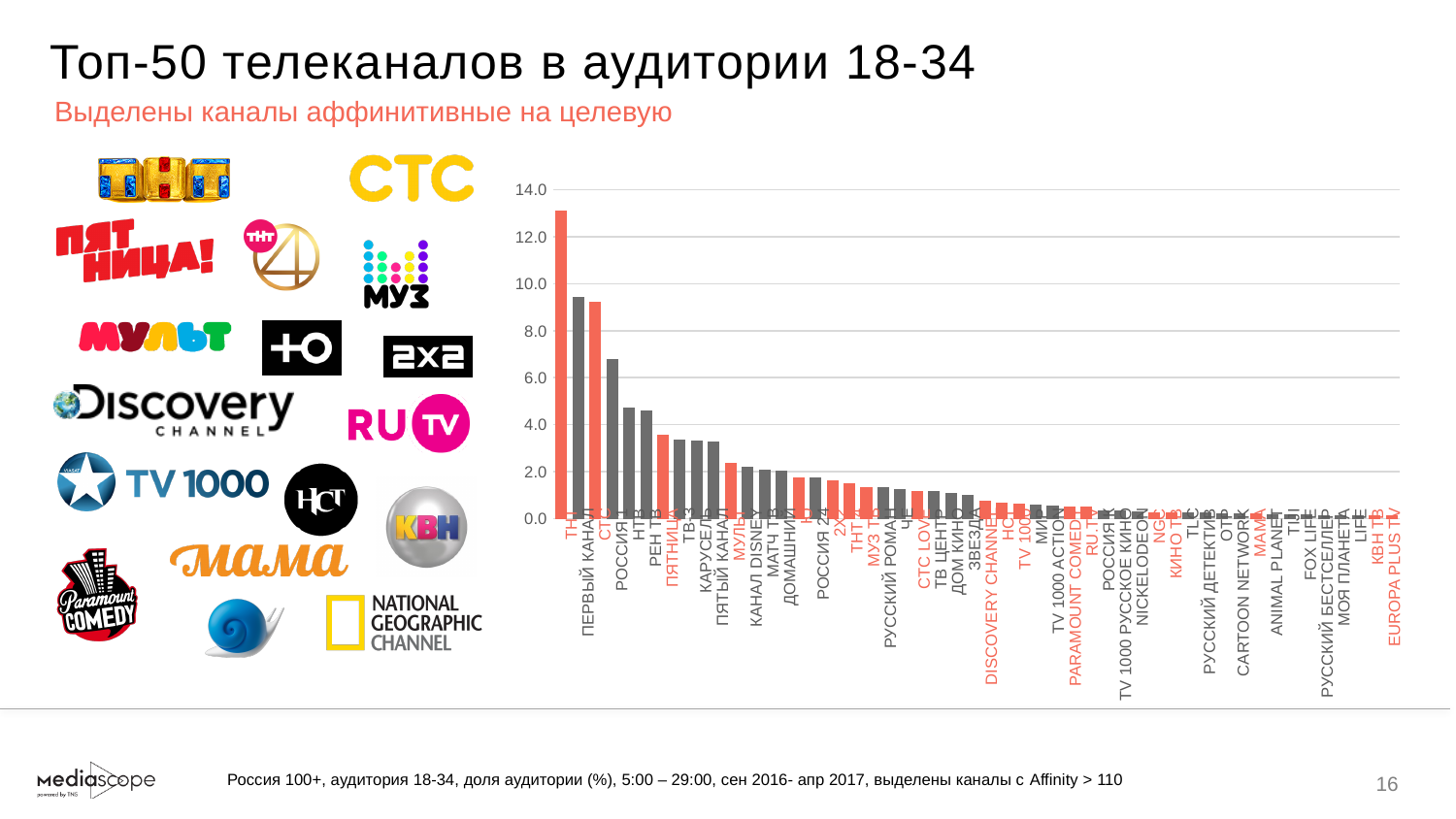
Do the bar values rise or fall from left to right along the x axis? Fall Is the value for ПЕРВЫЙ КАНАЛ greater or less than 8.0? greater Is the value for ТНТ greater or less than 12.0? greater Is the value for ПЯТНИЦА greater or less than 4.0? less Which has a larger value, ТНТ or ПЕРВЫЙ КАНАЛ? ТНТ Which has a larger value, НТВ or РОССИЯ 1? РОССИЯ 1 Which channel has the highest bar in the chart? ТНТ What is the highest value shown on the vertical axis of the chart? 14.0 How many channels are included in the chart, according to the slide title? 50 What kind of chart is shown on the slide? Bar chart